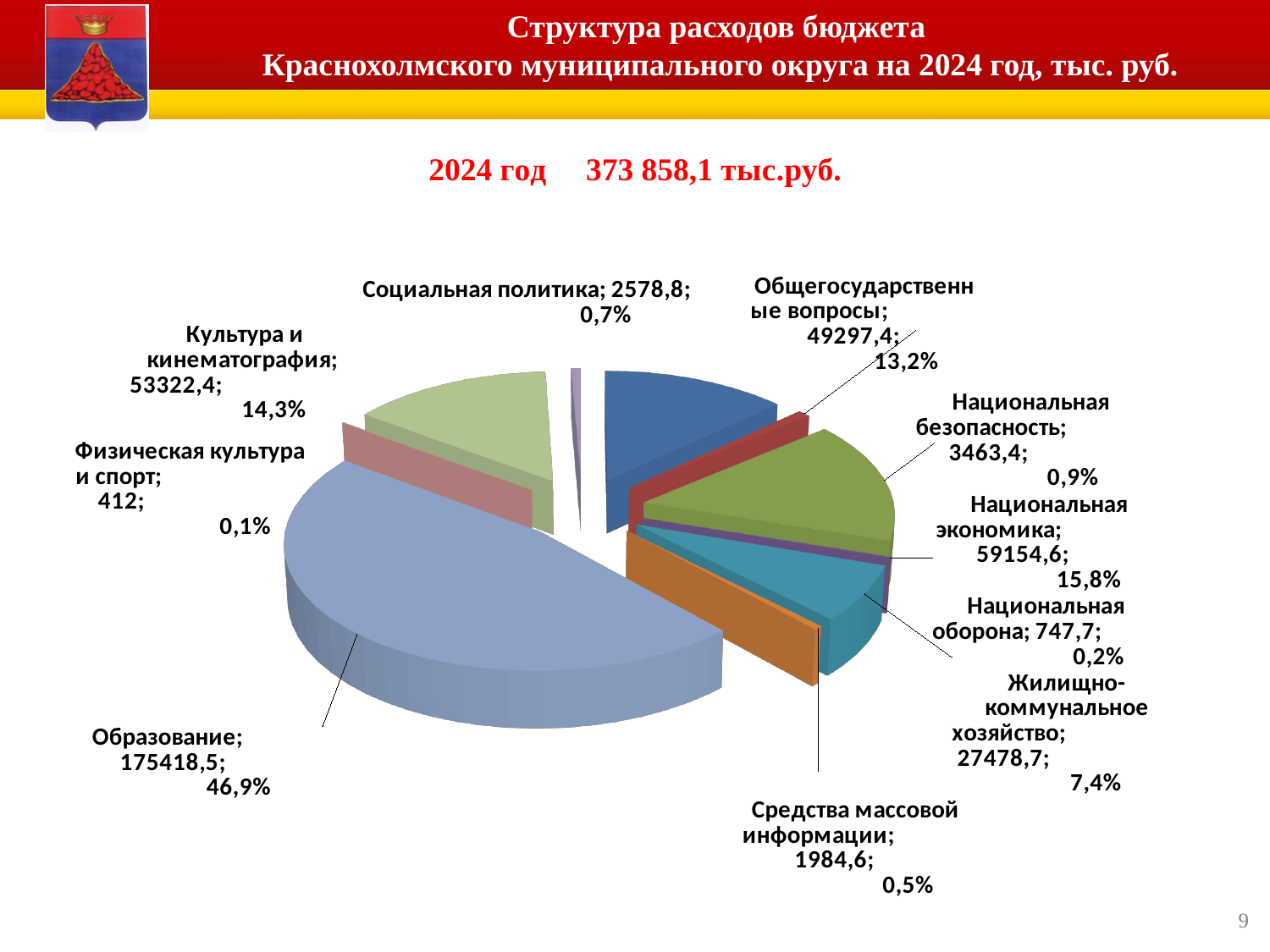
What total amount for 2024 is stated above the chart? 373 858,1 тыс.руб. Which category has the smallest slice of the pie? Физическая культура и спорт Which category has the largest slice of the pie? Образование What kind of chart is shown on the slide? pie chart Which is larger, Национальная экономика or Общегосударственные вопросы? Национальная экономика What is the value for Национальная экономика? 59154,6 What is the value for Образование? 175418,5 What is the value for Жилищно-коммунальное хозяйство? 27478,7 What share of the pie does Культура и кинематография take? 14,3% What is the difference between the values for Национальная безопасность and Социальная политика? 884,6 What share of the pie does Общегосударственные вопросы take? 13,2% How many categories (slices) does the pie chart show? 10